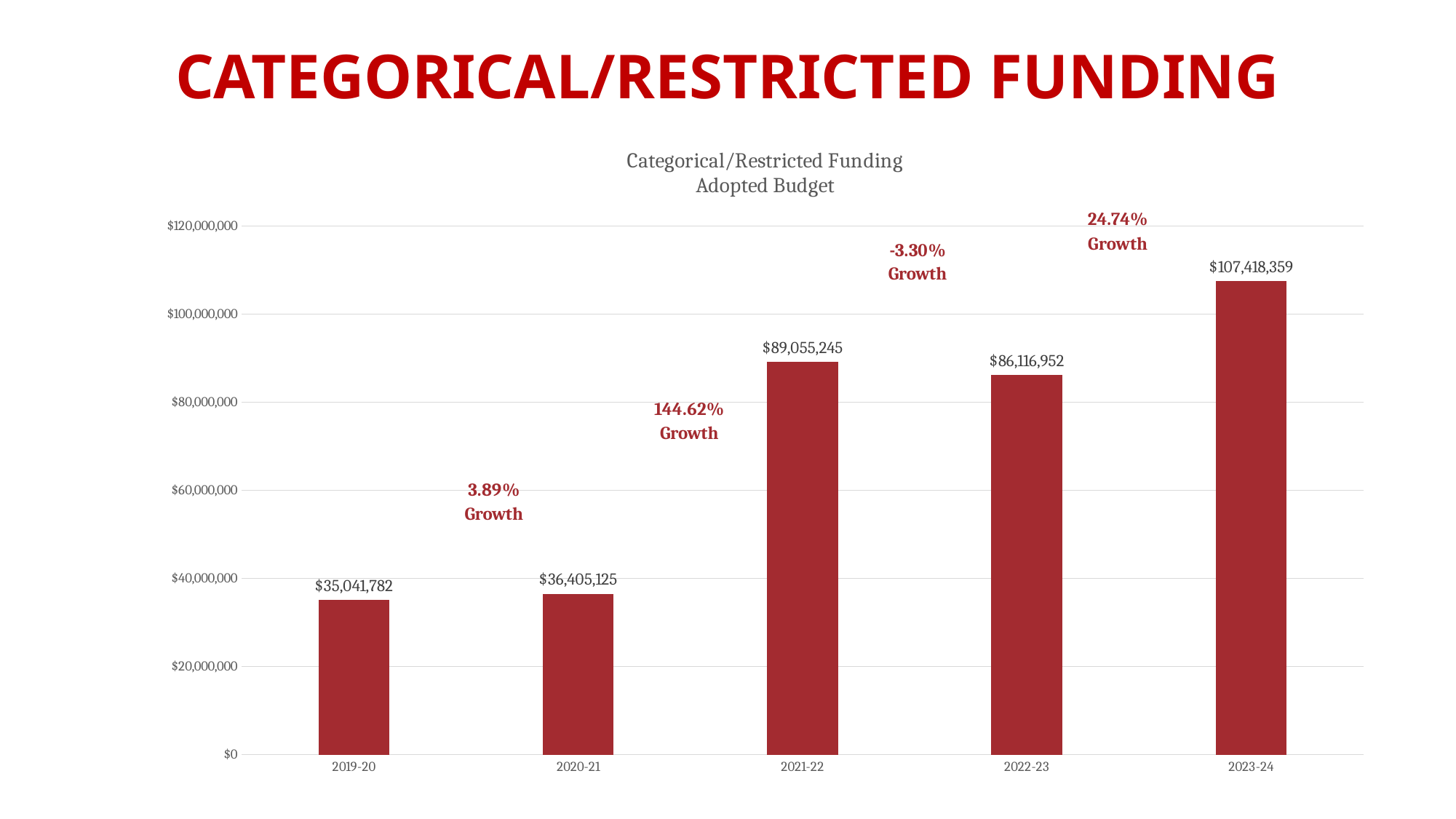
Which year has the lowest categorical/restricted funding? 2019-20 What is the difference between the 2021-22 and 2022-23 values? $2,938,293 What is the difference between the 2023-24 and 2022-23 values? $21,301,407 Which is larger, the value for 2021-22 or the value for 2022-23? 2021-22 Is the value for 2023-24 greater or less than $100,000,000? greater What kind of chart is shown on the slide? bar chart What is the adopted budget value for 2021-22? $89,055,245 How many years are shown on the x axis? 5 What is the title of the chart? Categorical/Restricted Funding Adopted Budget What growth percentage is shown between 2020-21 and 2021-22? 144.62% What is the adopted budget value for 2019-20? $35,041,782 Which year has the highest categorical/restricted funding? 2023-24